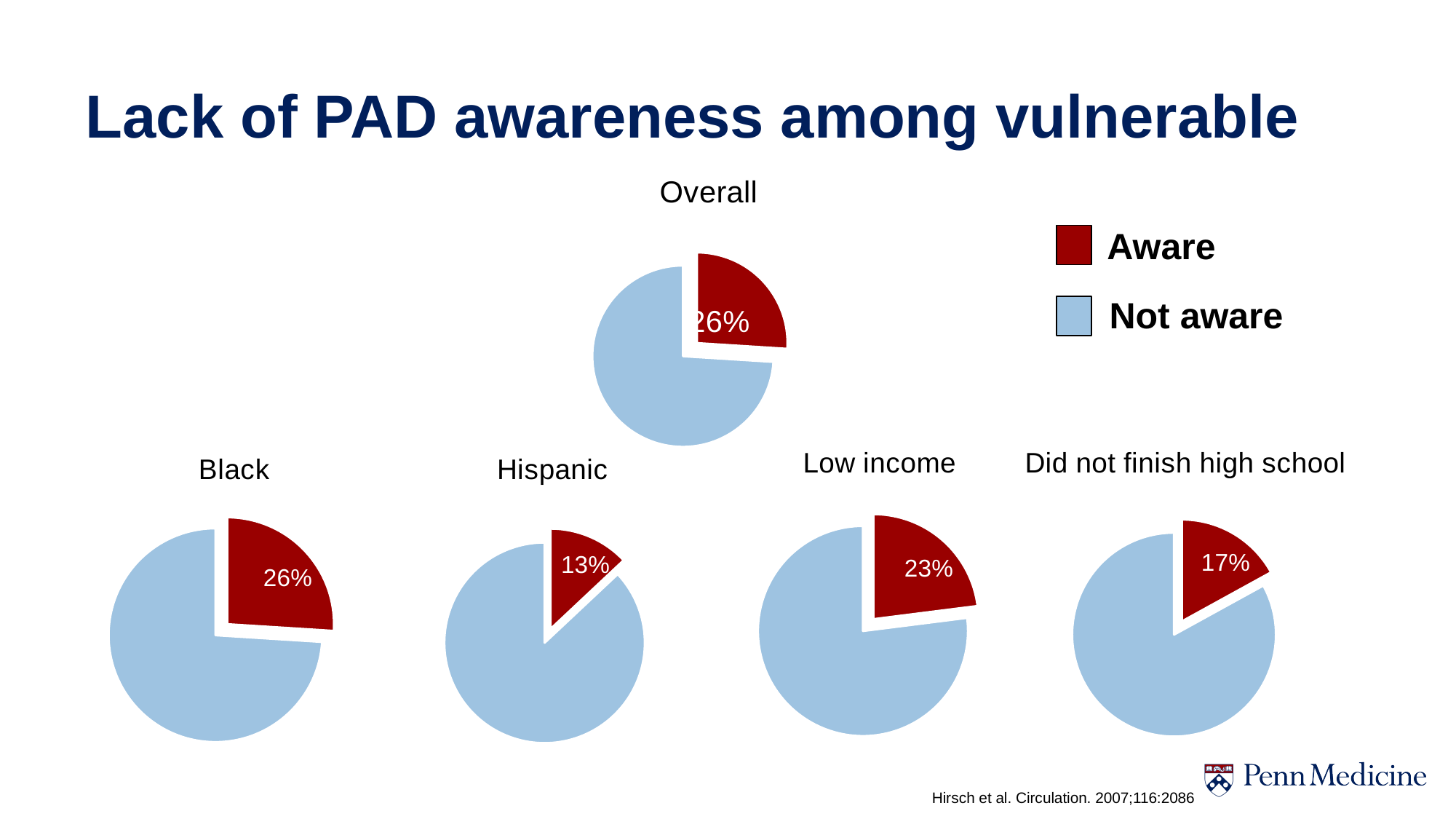
Across the five pie charts, which group has the lowest Aware percentage? Hispanic Among the four pie charts in the bottom row (Black, Hispanic, Low income, Did not finish high school), which group has the highest Aware percentage? Black In the Low income pie chart, what percentage is labelled as Aware? 23% In the Black pie chart, what percentage is labelled as Aware? 26% How many entries does the legend list? 2 What is the difference between the Aware percentage in the Black pie chart and the Aware percentage in the Hispanic pie chart? 13% In the Hispanic pie chart, what percentage is labelled as Aware? 13% In the Overall pie chart, what percentage is labelled as Aware? 26% How many pie charts are shown on the slide? 5 What kind of chart is used to show awareness for each group on this slide? Pie chart Comparing the Low income and Hispanic pie charts, which group has the larger Aware percentage? Low income In the Did not finish high school pie chart, what percentage is labelled as Aware? 17%